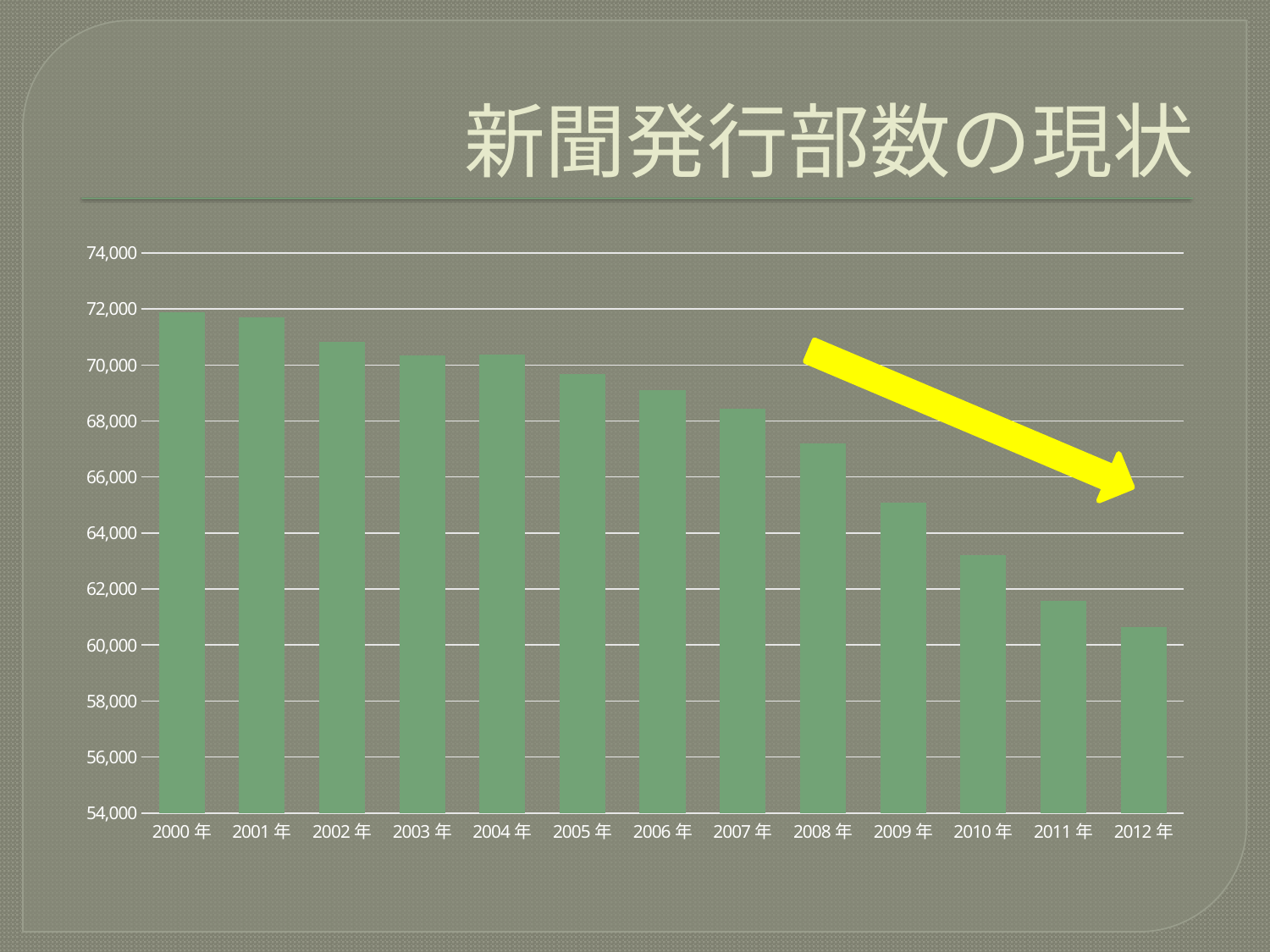
Do the values rise or fall from 2000 年 to 2012 年? fall What kind of chart is shown on the slide? bar chart Is the value for 2009 年 greater or less than 66,000? less Is the value for 2012 年 greater or less than 62,000? less Is the value for 2007 年 greater or less than 68,000? greater What colour are the bars in the chart? green How many years (bars) are plotted in the chart? 13 Which year has the highest value in the chart? 2000 年 Which year has the lowest value in the chart? 2012 年 What is the title of the slide containing the chart? 新聞発行部数の現状 Which is larger, the value for 2005 年 or the value for 2010 年? 2005 年